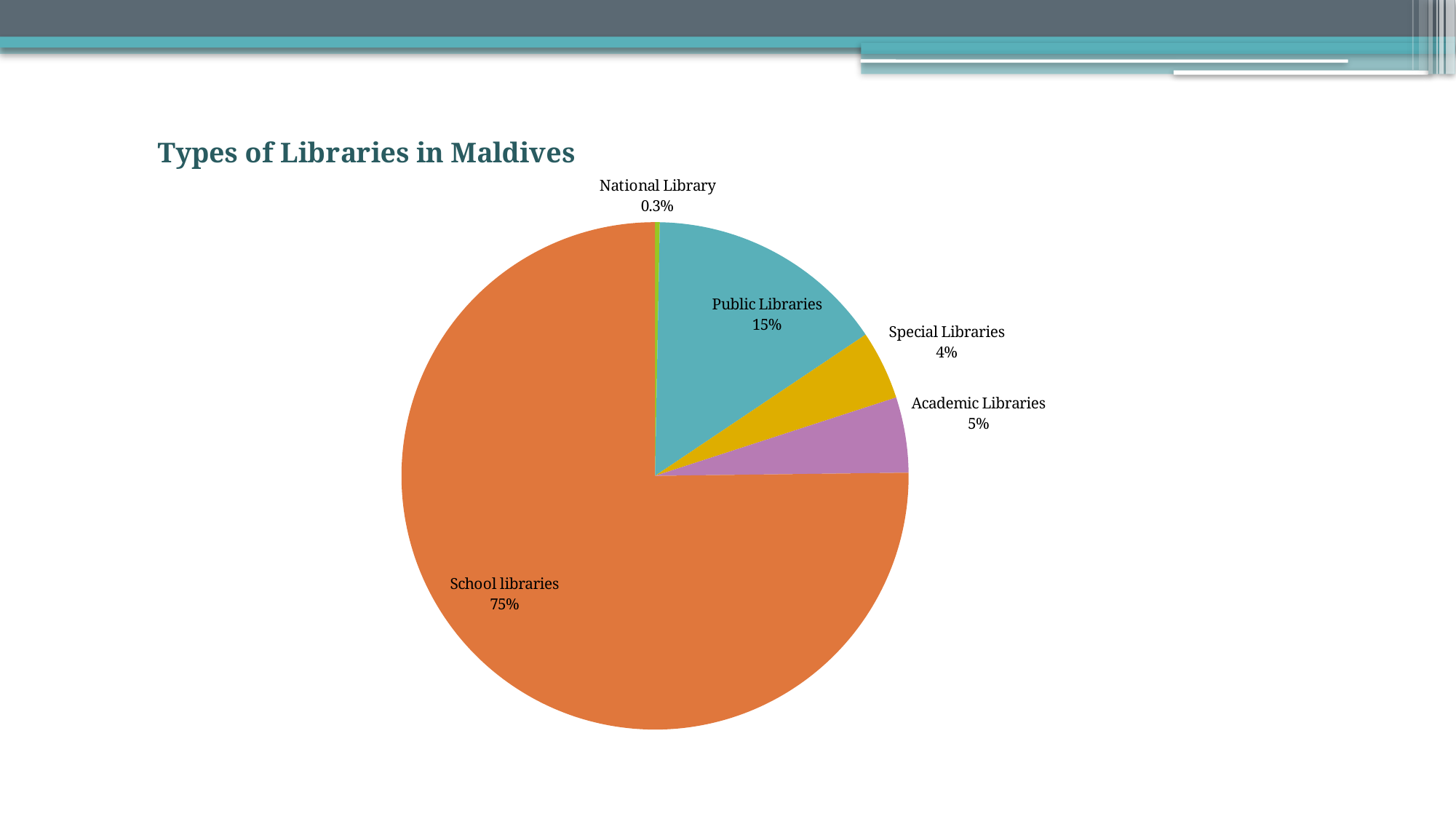
Which is larger, the share for Academic Libraries or Special Libraries? Academic Libraries What is the difference between the shares of School libraries and Public Libraries? 60% What kind of chart is shown on the slide? Pie chart What share of the pie do School libraries account for? 75% What is the value shown for Academic Libraries? 5% What is the value shown for National Library? 0.3% Which type of library has the smallest slice of the pie? National Library Which type of library has the largest slice of the pie? School libraries What is the title of the chart? Types of Libraries in Maldives What is the value shown for Special Libraries? 4% How many slices does the pie chart have? 5 What is the value shown for Public Libraries? 15%